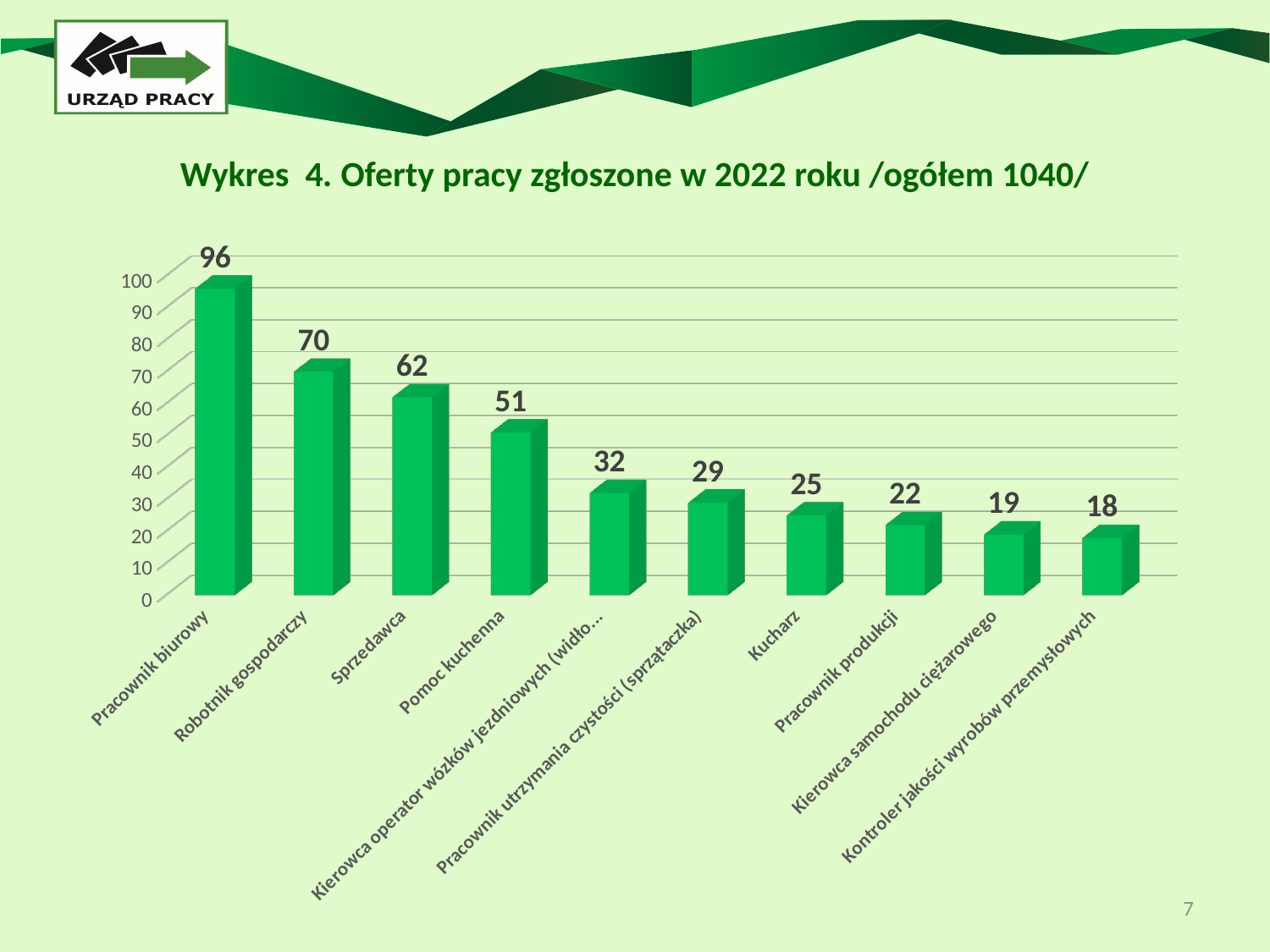
What is the difference between the values for Robotnik gospodarczy and Pomoc kuchenna? 19 What is the title of the chart? Wykres 4. Oferty pracy zgłoszone w 2022 roku /ogółem 1040/ What is the value for Pracownik biurowy? 96 Do the values rise or fall from left to right along the x axis? Fall Which category has the highest value? Pracownik biurowy What is the value for Kucharz? 25 How many categories are shown in the chart? 10 What is the value for Pracownik produkcji? 22 Which is larger, the value for Pracownik utrzymania czystości (sprzątaczka) or the value for Kierowca samochodu ciężarowego? Pracownik utrzymania czystości (sprzątaczka) Which category has the lowest value? Kontroler jakości wyrobów przemysłowych What kind of chart is shown on the slide? Bar chart What is the value for Sprzedawca? 62